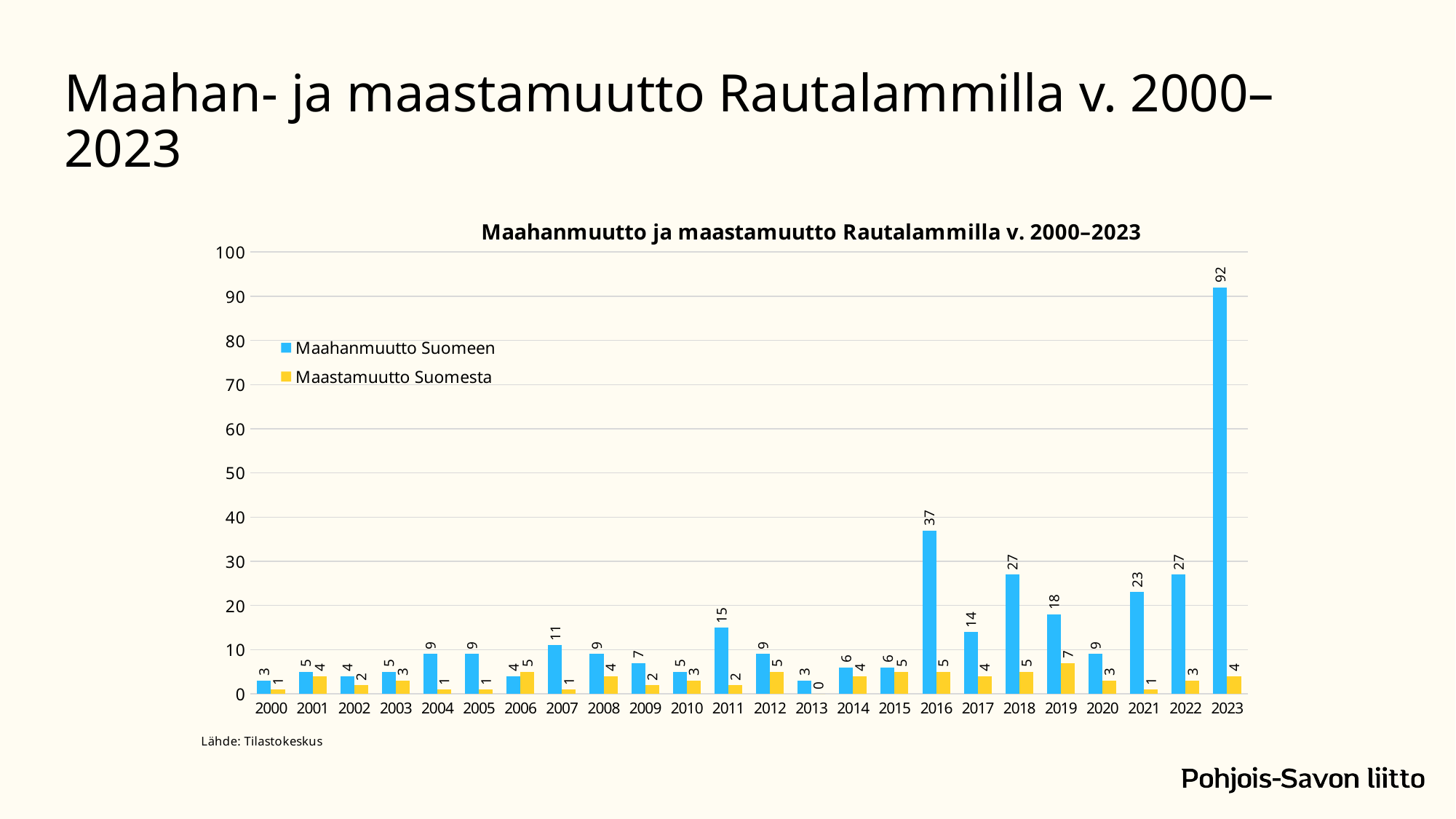
What kind of chart is shown on the slide? Bar chart Which year has the lowest value for Maastamuutto Suomesta? 2013 Which year has the highest value for Maahanmuutto Suomeen? 2023 What is the value of Maahanmuutto Suomeen in 2023? 92 Which is larger in 2006, Maahanmuutto Suomeen or Maastamuutto Suomesta? Maastamuutto Suomesta What is the value of Maahanmuutto Suomeen in 2016? 37 What is the value of Maastamuutto Suomesta in 2019? 7 How many series does the legend list? 2 What is the source cited below the chart? Tilastokeskus Is the value for Maahanmuutto Suomeen in 2023 greater or less than 90? greater What is the difference between Maahanmuutto Suomeen and Maastamuutto Suomesta in 2023? 88 How many years are shown on the x axis of the chart? 24